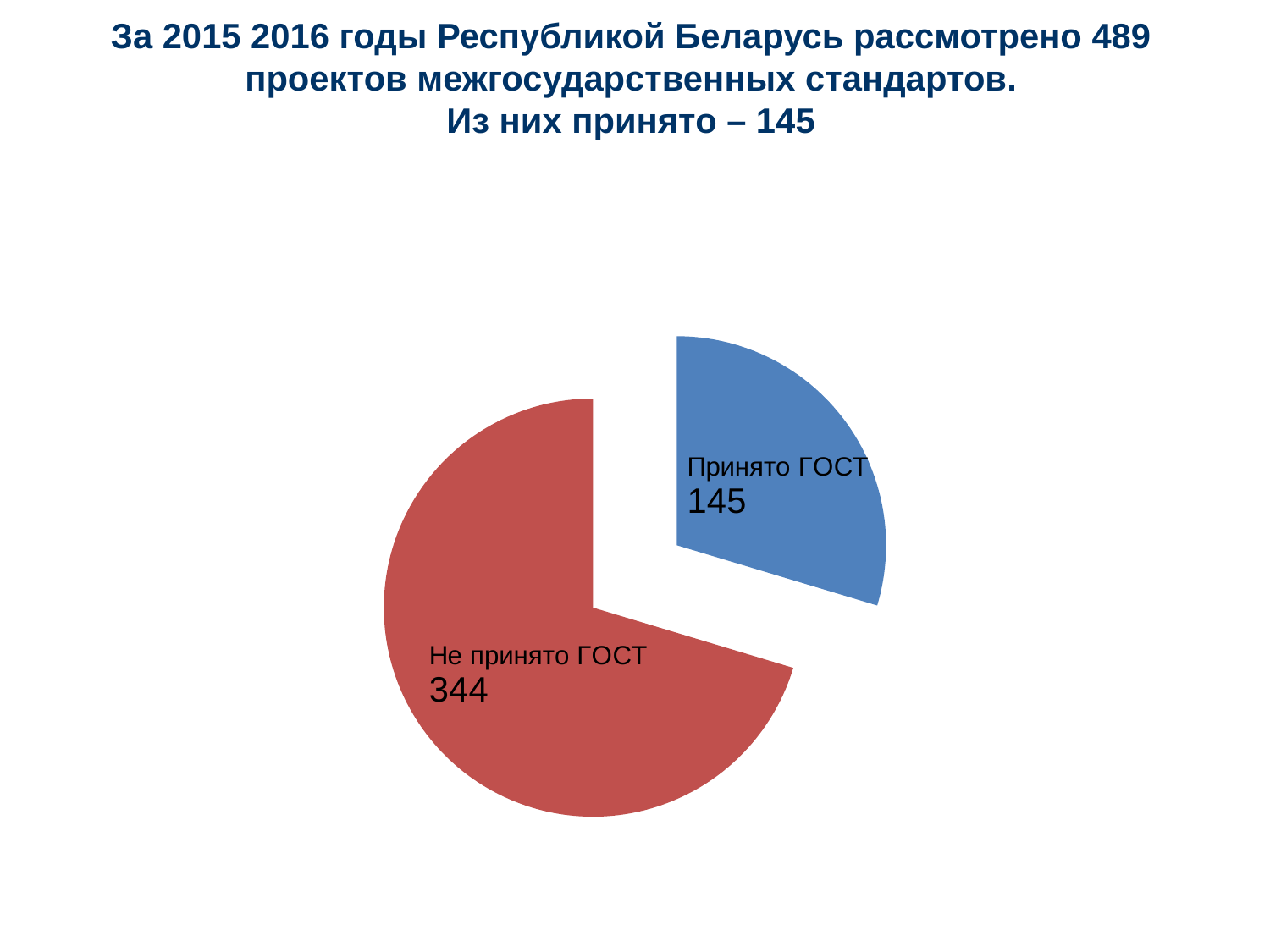
Which is larger: the value for "Принято ГОСТ" or the value for "Не принято ГОСТ"? Не принято ГОСТ What value is shown for the slice labelled "Не принято ГОСТ"? 344 What value is shown for the slice labelled "Принято ГОСТ"? 145 Which slice of the pie is the smallest? Принято ГОСТ How many slices does the pie chart have? 2 What colour is the slice labelled "Принято ГОСТ"? Blue What is the total of the two slice values in the pie chart? 489 What is the difference between the values for "Не принято ГОСТ" and "Принято ГОСТ"? 199 What kind of chart is shown on the slide? Pie chart Which slice of the pie is the largest? Не принято ГОСТ What colour is the slice labelled "Не принято ГОСТ"? Red